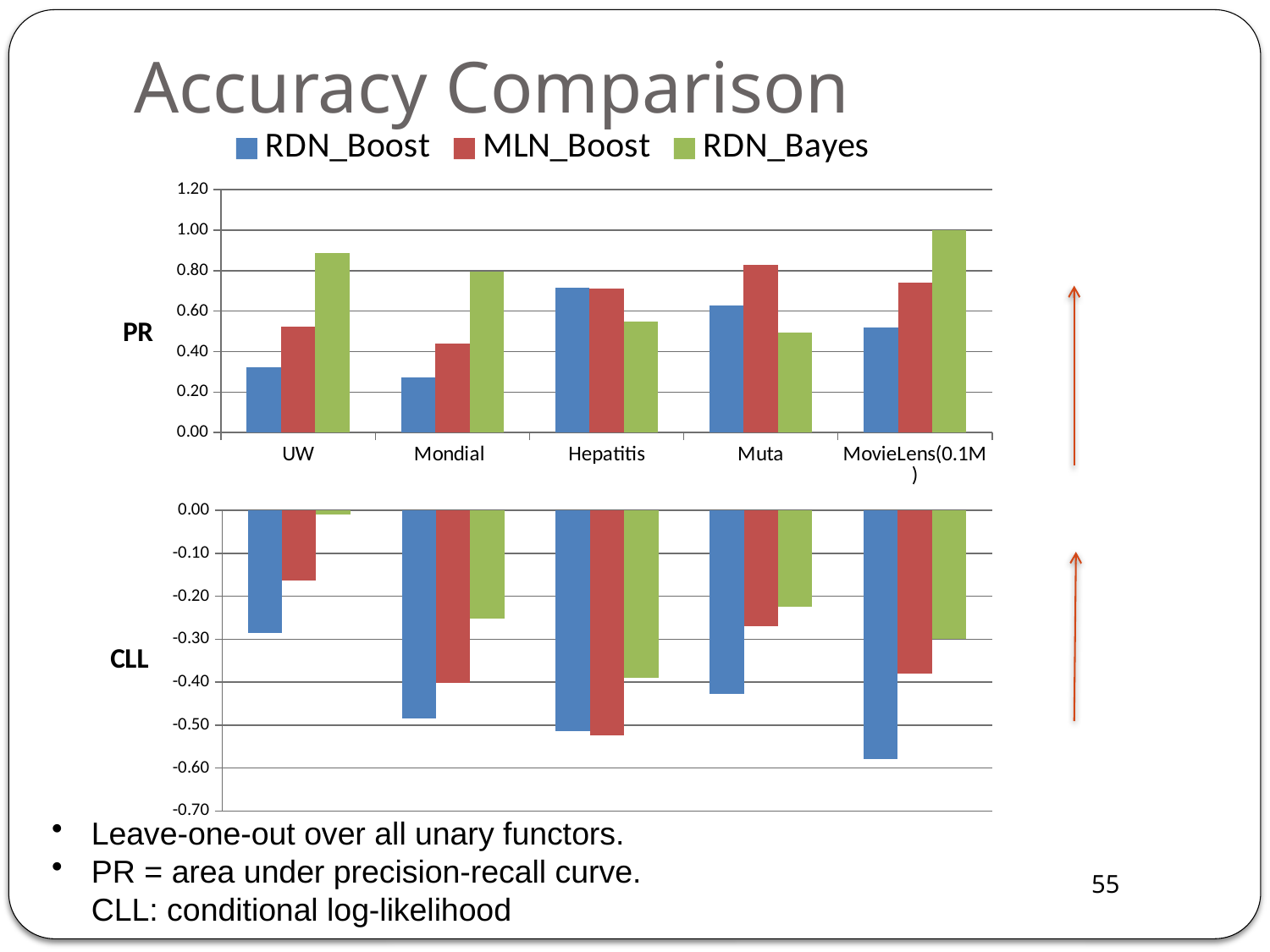
What is the title of the slide containing the charts? Accuracy Comparison In the CLL chart, which series has the lowest (most negative) value for MovieLens(0.1M)? RDN_Boost In the CLL chart, is the value for RDN_Boost on Hepatitis greater or less than -0.40? less How many datasets (categories) are shown along the x axis of the PR chart? 5 In the PR chart, which is larger for UW: RDN_Boost or MLN_Boost? MLN_Boost In the PR chart, which series has the highest value for UW? RDN_Bayes In the PR chart, is the value for RDN_Boost on Mondial greater or less than 0.40? less In the PR chart, which series has the highest value for Muta? MLN_Boost In the CLL chart, is the value for RDN_Bayes on UW greater or less than -0.10? greater What type of chart is the PR chart at the top of the slide? Bar chart How many series does the legend list? 3